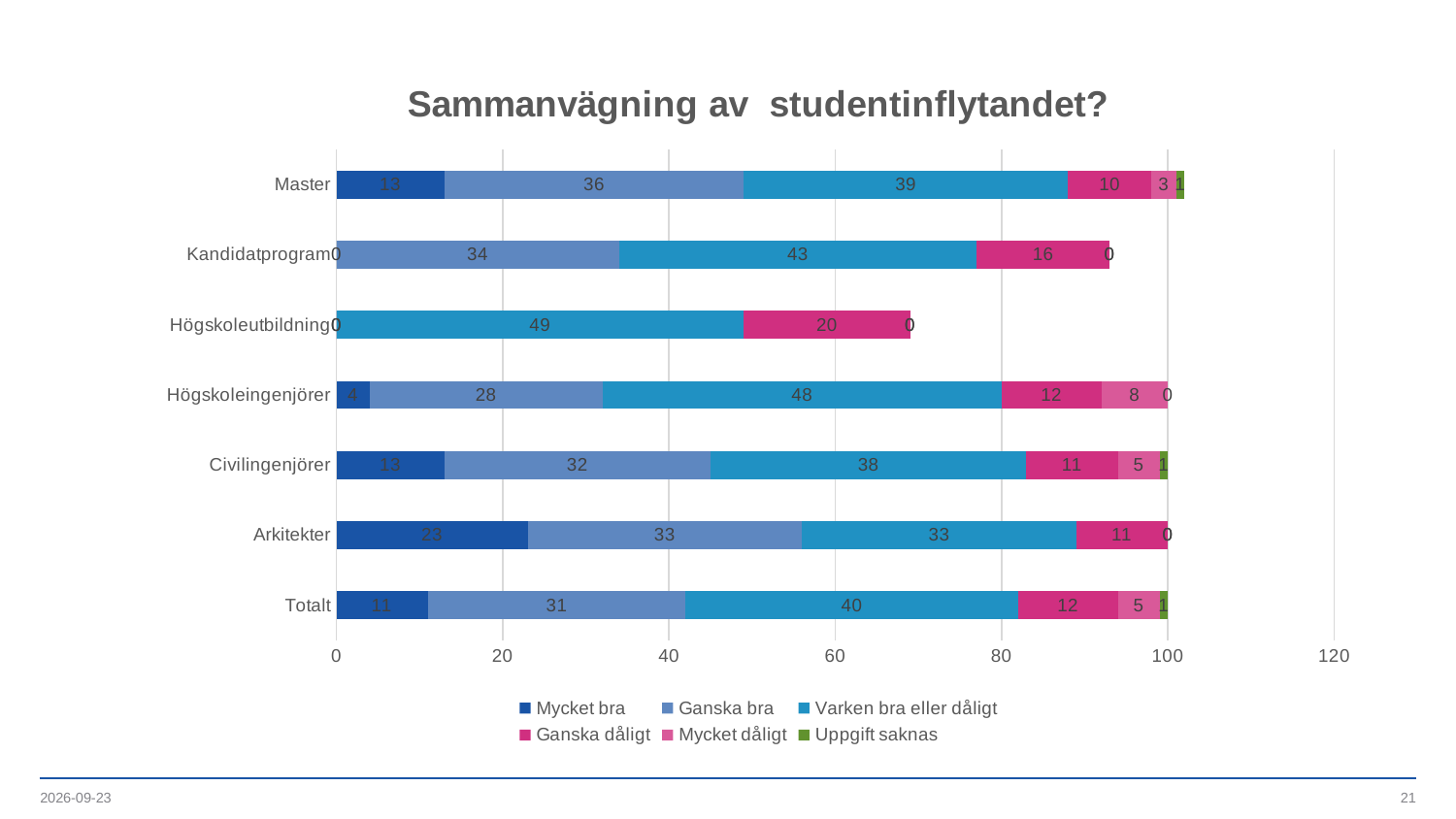
Which category has the highest value for 'Mycket bra'? Arkitekter What is the title of the chart? Sammanvägning av studentinflytandet? What is the difference between the 'Ganska bra' values for Master and Civilingenjörer? 4 What is the value of 'Ganska dåligt' for Kandidatprogram? 16 How many series does the legend list? 6 What is the value of 'Varken bra eller dåligt' for Högskoleutbildning? 49 How many categories are plotted on the y axis? 7 Which category has the highest value for 'Ganska dåligt'? Högskoleutbildning What is the value of 'Mycket bra' for Arkitekter? 23 What kind of chart is shown on the slide? Stacked bar chart What is the value of 'Mycket dåligt' for Högskoleingenjörer? 8 Which has the larger 'Ganska bra' value, Arkitekter or Högskoleingenjörer? Arkitekter